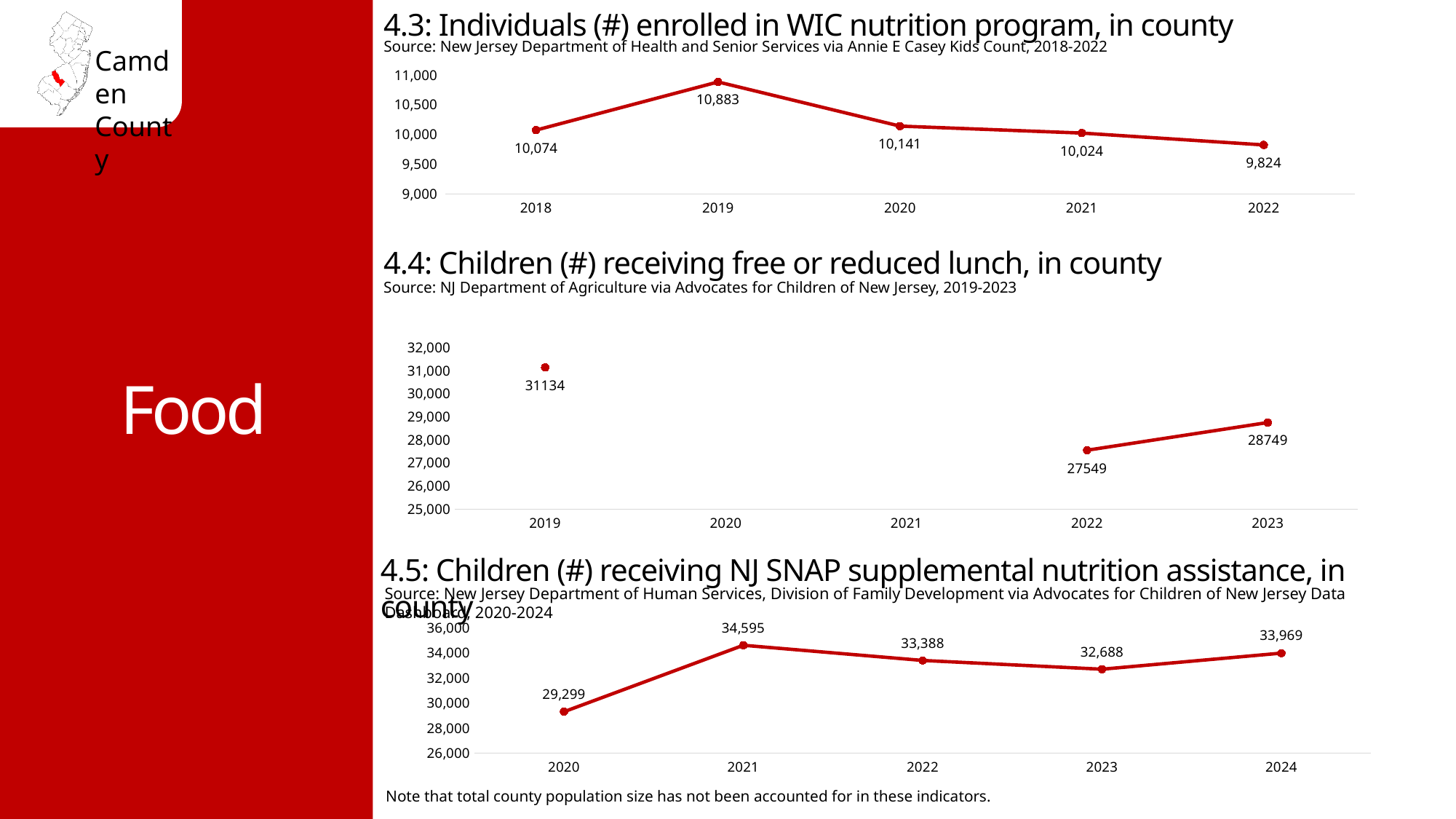
In the chart '4.3: Individuals (#) enrolled in WIC nutrition program, in county', what is the difference between the 2019 and 2022 values? 1,059 In the chart '4.4: Children (#) receiving free or reduced lunch, in county', what is the difference between the 2023 and 2022 values? 1200 In the chart '4.3: Individuals (#) enrolled in WIC nutrition program, in county', what is the value for 2019? 10,883 In the chart '4.3: Individuals (#) enrolled in WIC nutrition program, in county', which year has the lowest value? 2022 In the chart '4.3: Individuals (#) enrolled in WIC nutrition program, in county', do values rise or fall from 2019 to 2022? fall In the chart '4.5: Children (#) receiving NJ SNAP supplemental nutrition assistance, in county', what is the value for 2023? 32,688 In the chart '4.5: Children (#) receiving NJ SNAP supplemental nutrition assistance, in county', is the value for 2020 greater or less than 30,000? less In the chart '4.4: Children (#) receiving free or reduced lunch, in county', what is the value for 2019? 31134 In the chart '4.4: Children (#) receiving free or reduced lunch, in county', which is larger, the 2022 value or the 2023 value? 2023 What type of chart is '4.5: Children (#) receiving NJ SNAP supplemental nutrition assistance, in county'? line chart In the chart '4.5: Children (#) receiving NJ SNAP supplemental nutrition assistance, in county', which year has the highest value? 2021 In the chart '4.3: Individuals (#) enrolled in WIC nutrition program, in county', how many data points are plotted? 5